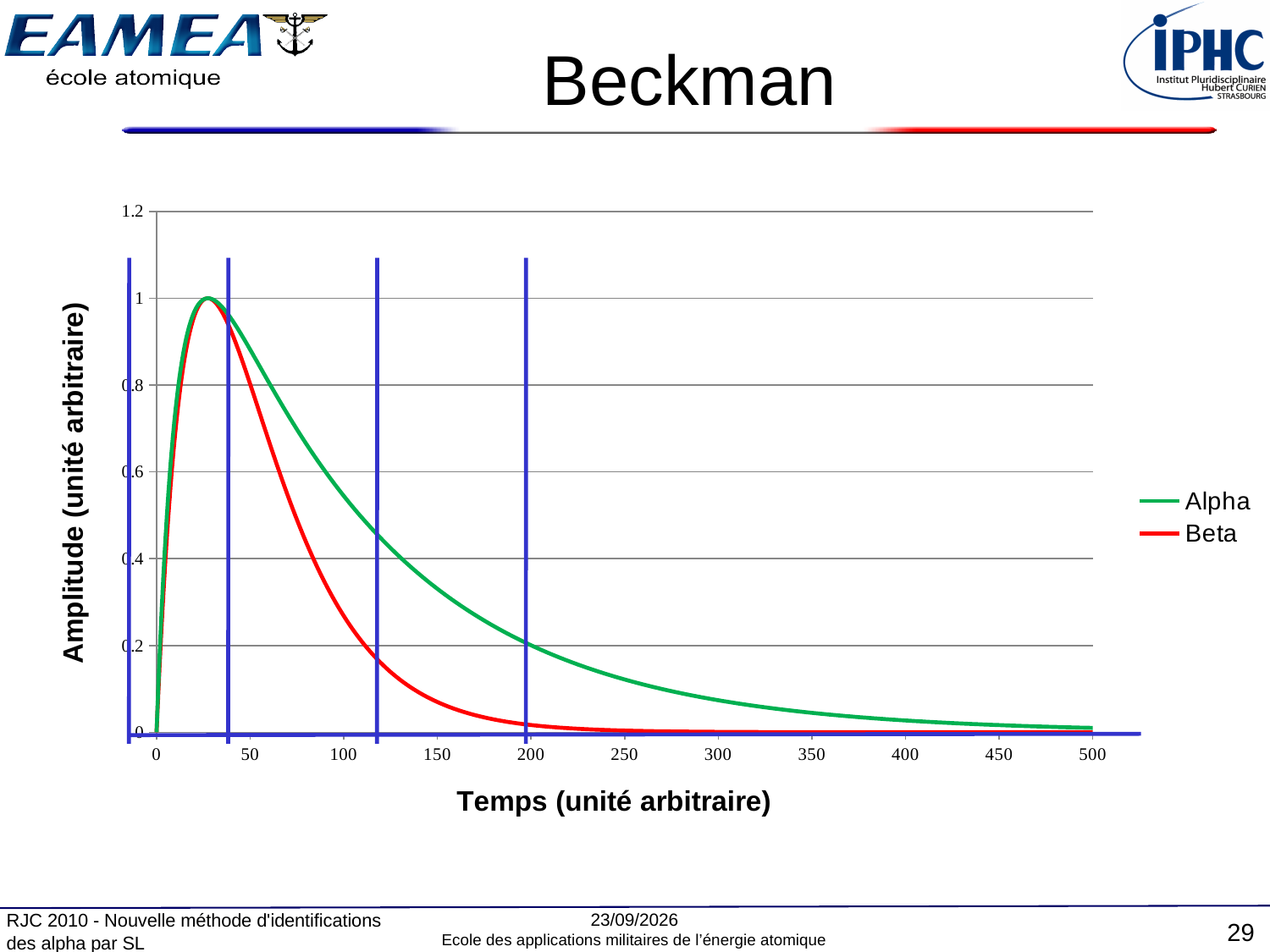
Is the value of Beta at time 150 greater or less than 0.2? less Is the value of Alpha at time 100 greater or less than 0.4? greater At time 300, which series has the larger value, Alpha or Beta? Alpha Is the value of Beta at time 100 greater or less than 0.4? less How many series does the legend list? 2 What is the title of the x axis? Temps (unité arbitraire) What kind of chart is shown on the slide? line chart Which series decreases faster after the peak, Alpha or Beta? Beta After their peak near time 30, do the Alpha and Beta curves rise or fall as time increases? fall What are the names of the two series in the legend? Alpha and Beta